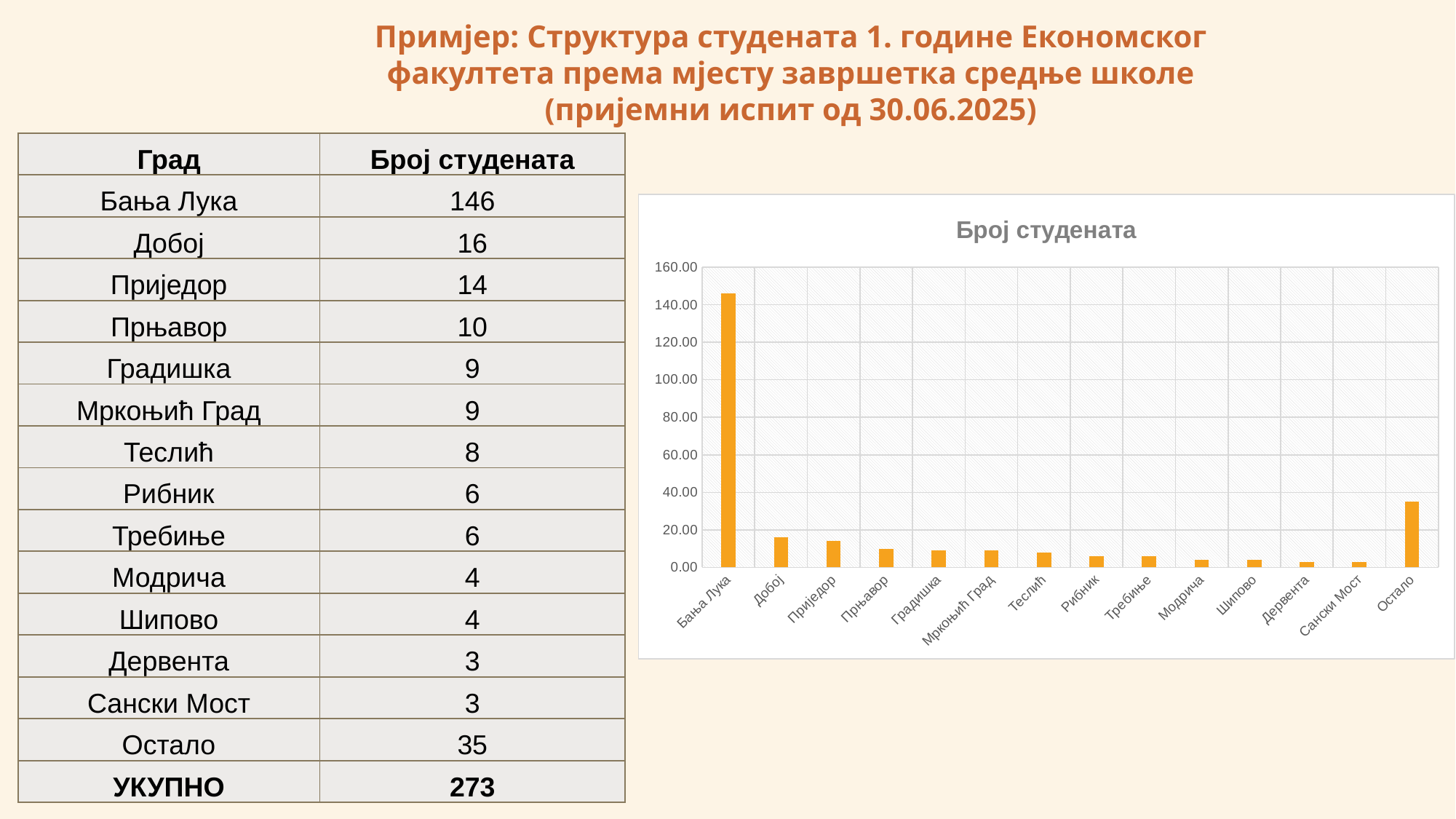
Is the value for Остало greater or less than 40? less What is the title of the chart? Број студената What is the difference between the number of students for Бања Лука and for Добој? 130 What is the number of students for Бања Лука? 146 What is the number of students for Остало? 35 Which is larger, the bar for Пријeдор or the bar for Модрича? Пријeдор Is the value for Добој greater or less than 20? less How many categories are plotted on the x axis of the chart? 14 Which is larger, the bar for Остало or the bar for Добој? Остало Is the value for Бања Лука greater or less than 140? greater What kind of chart is shown on the slide? bar chart Which category has the highest bar in the chart? Бања Лука